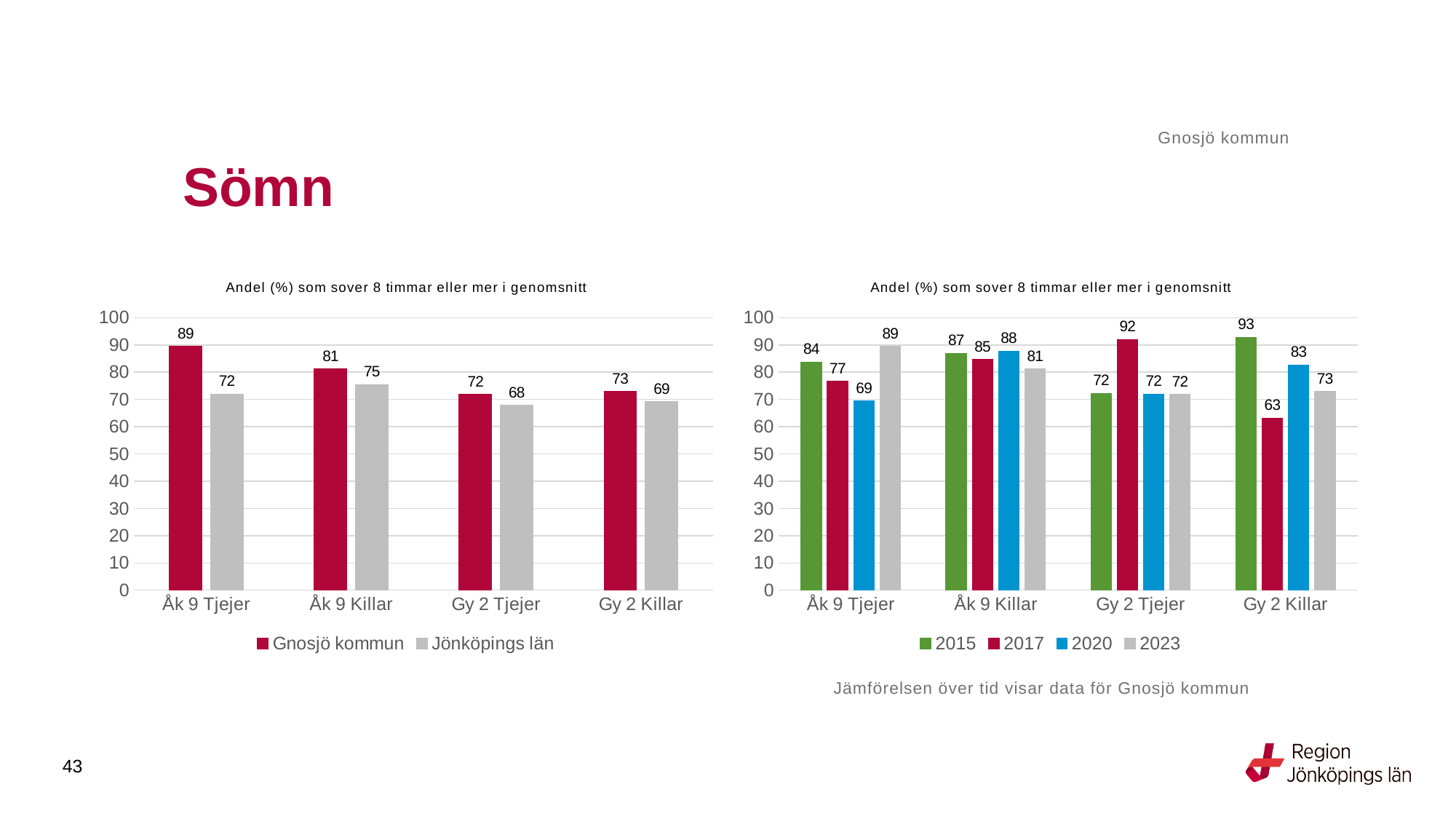
In the right chart, which is larger for Gy 2 Killar: 2015 or 2023? 2015 In the left chart, what is the difference between Gnosjö kommun and Jönköpings län for Åk 9 Tjejer? 17 In the left chart, what is the value for Jönköpings län for Gy 2 Tjejer? 68 In the right chart, how many categories are shown on the x axis? 4 In the left chart, how many series does the legend list? 2 What kind of chart is the left chart? Bar chart In the left chart, which category has the highest value for Gnosjö kommun? Åk 9 Tjejer In the left chart, what is the value for Gnosjö kommun for Åk 9 Tjejer? 89 In the right chart, which year has the lowest value for Åk 9 Tjejer? 2020 In the right chart, what is the value for 2020 for Åk 9 Killar? 88 In the right chart, how many series does the legend list? 4 In the right chart, what is the value for 2017 for Gy 2 Killar? 63